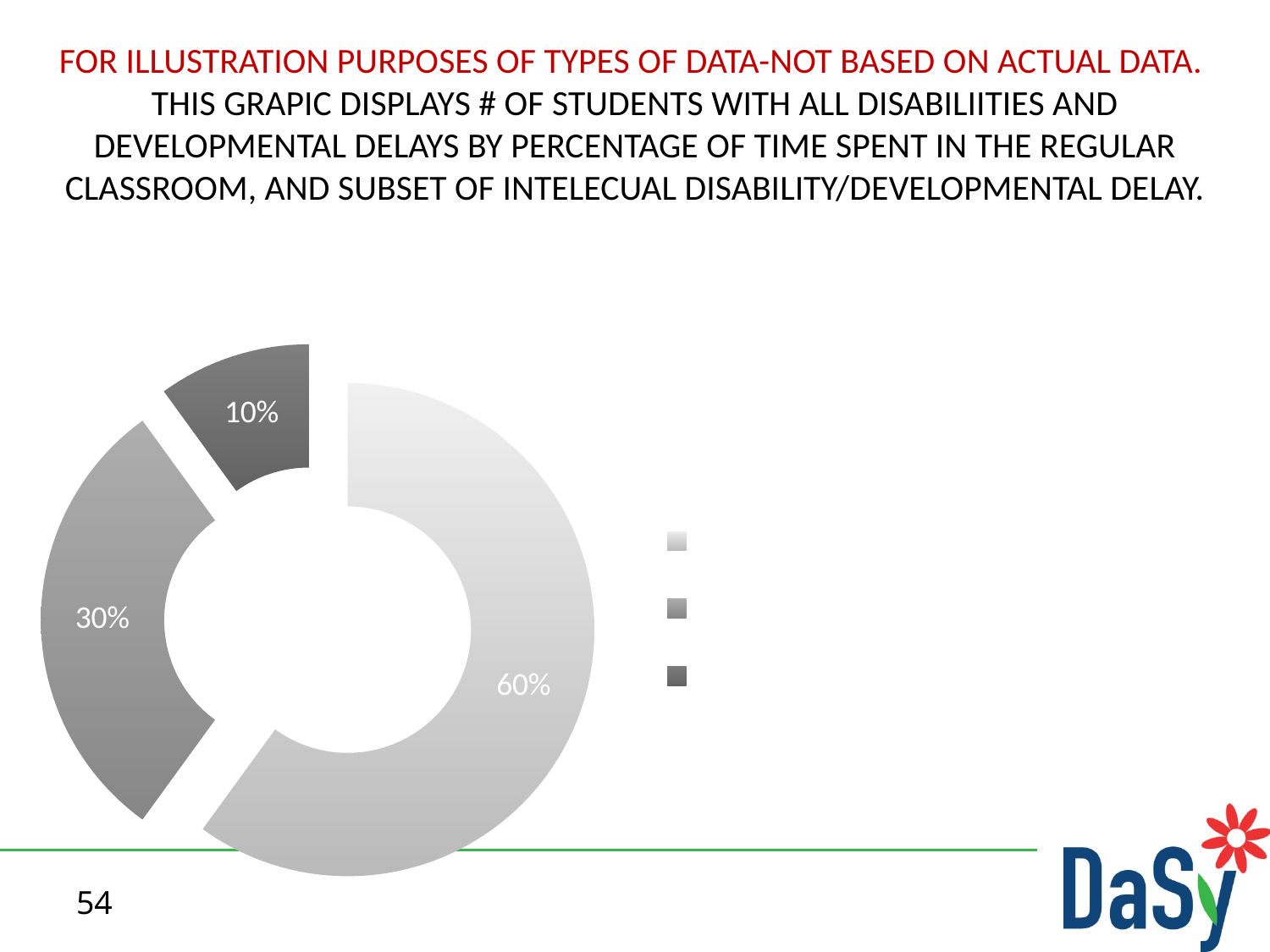
What is the value of the smallest slice in the doughnut chart? 10% What is the value of the lightest grey slice in the doughnut chart? 60% What is the value of the darkest grey slice in the doughnut chart? 10% How many entries does the legend of the doughnut chart list? 3 What is the difference between the 60% slice and the 30% slice in the doughnut chart? 30% What is the value of the medium grey slice on the left of the doughnut chart? 30% How many slices does the doughnut chart have? 3 Which is larger in the doughnut chart, the darkest grey slice or the medium grey slice? The medium grey slice What do the three slice values in the doughnut chart add up to? 100% What is the value of the largest slice in the doughnut chart? 60% What is the difference between the largest and smallest slices in the doughnut chart? 50% What kind of chart is shown on the slide? Doughnut chart